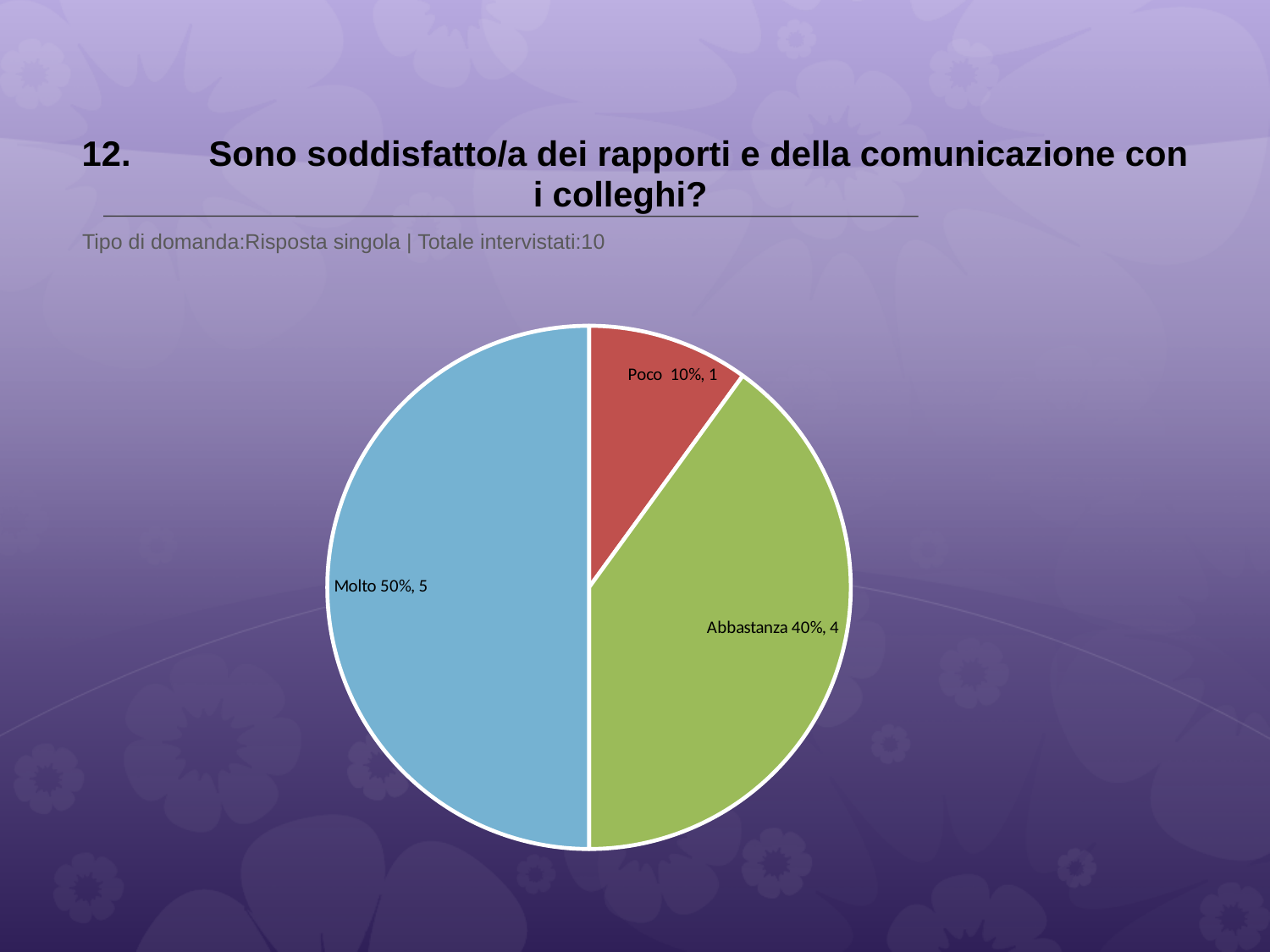
What is the difference in respondents between Molto and Poco? 4 Which is larger, the Abbastanza slice or the Poco slice? Abbastanza What kind of chart is shown on the slide? pie chart Which category has the largest slice? Molto What colour is the Abbastanza slice? green Which category has the smallest slice? Poco What percentage share does the Abbastanza slice have? 40% How many slices does the pie chart have? 3 What percentage share does the Poco slice have? 10% How many respondents answered Abbastanza? 4 What percentage share does the Molto slice have? 50% How many respondents answered Molto? 5